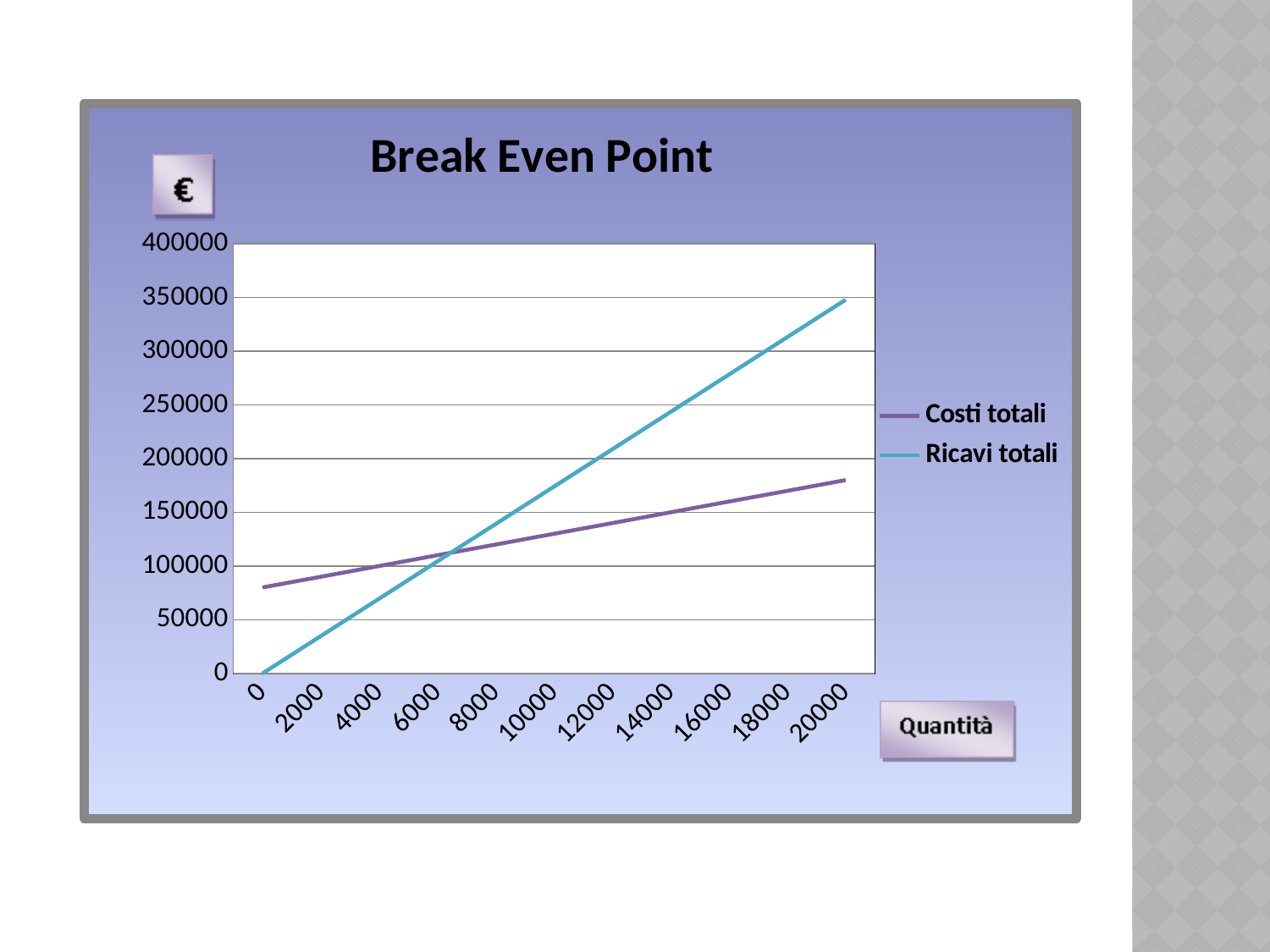
Is the value of Costi totali at quantity 20000 greater or less than 200000? less What is the value of Ricavi totali at quantity 0? 0 How many series does the legend list? 2 What kind of chart is shown on the slide? line chart At quantity 20000, which series has the larger value, Costi totali or Ricavi totali? Ricavi totali At quantity 2000, which series has the larger value, Costi totali or Ricavi totali? Costi totali Is the value of Ricavi totali at quantity 20000 greater or less than 300000? greater How many tick labels are shown on the x axis? 11 What is the title of the chart? Break Even Point Do the values of Ricavi totali rise or fall as quantity increases along the x axis? rise Which series is drawn in purple? Costi totali Is the value of Costi totali at quantity 0 greater or less than 50000? greater